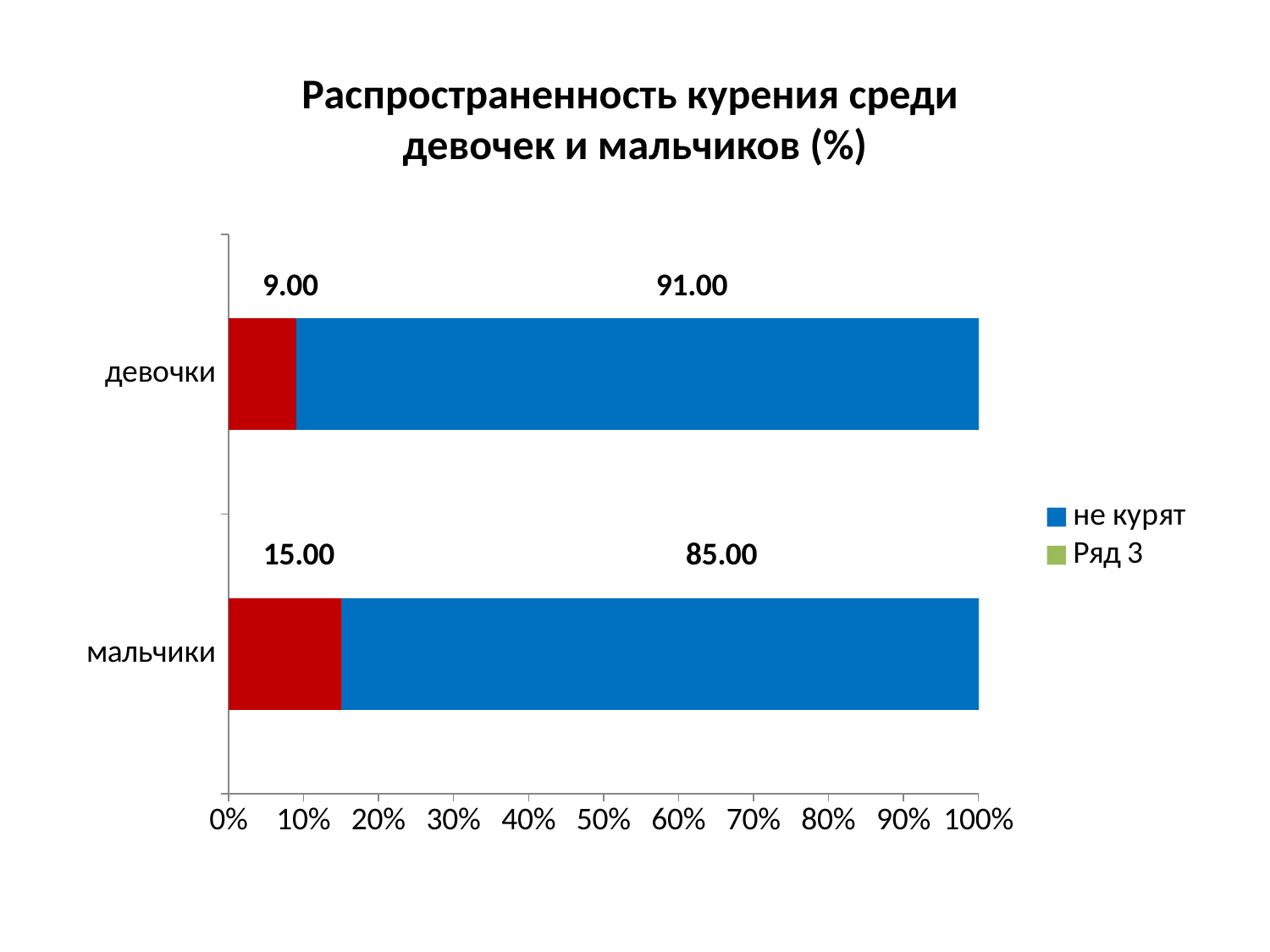
What is the value of the blue 'не курят' segment for мальчики? 85.00 Which category has the larger red segment, девочки or мальчики? мальчики How many categories are shown on the vertical axis? 2 What is the difference between the 'не курят' values for девочки and мальчики? 6.00 What kind of chart is shown on the slide? Stacked bar chart Which category has the higher 'не курят' value? девочки What is the value of the blue 'не курят' segment for девочки? 91.00 What is the difference between the red segment values for мальчики and девочки? 6.00 How many series does the legend list? 2 What is the title of the chart? Распространенность курения среди девочек и мальчиков (%) What is the value of the red segment for девочки? 9.00 What is the value of the red segment for мальчики? 15.00